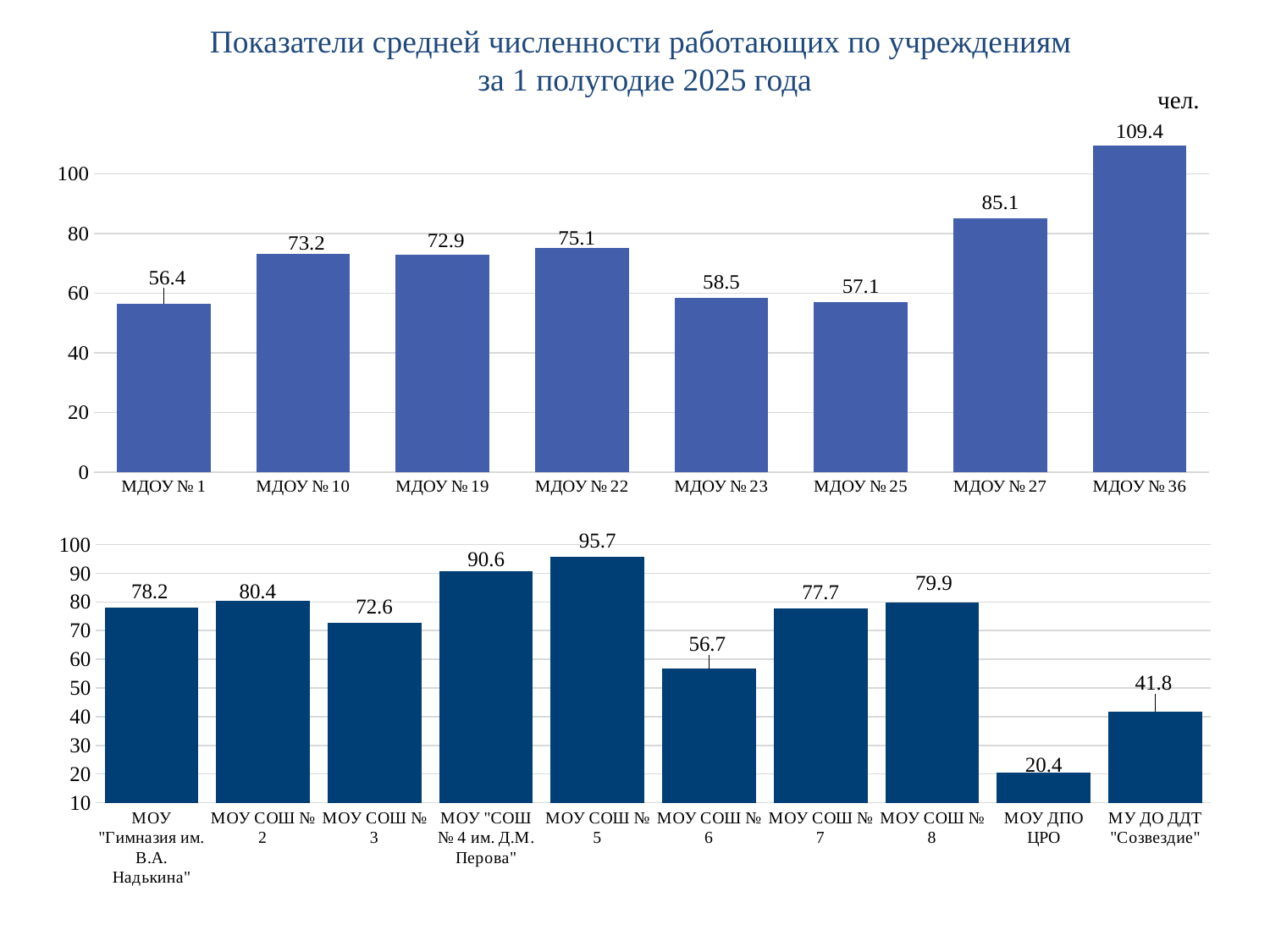
On the top chart, which institution has the highest value? МДОУ № 36 On the top chart, what is the difference between МДОУ № 36 and МДОУ № 27? 24.3 On the bottom chart, which institution has the lowest value? МОУ ДПО ЦРО What type of chart is the top chart? Bar chart On the top chart, how many institutions are shown? 8 On the bottom chart, how many institutions are shown? 10 On the bottom chart, what is the value for МОУ СОШ № 6? 56.7 On the bottom chart, which institution has the highest value? МОУ СОШ № 5 On the bottom chart, which is larger: the value for МОУ СОШ № 2 or МОУ СОШ № 3? МОУ СОШ № 2 On the top chart, what is the value for МДОУ № 27? 85.1 On the top chart, which institution has the lowest value? МДОУ № 1 On the bottom chart, what is the difference between МОУ "СОШ № 4 им. Д.М. Перова" and МУ ДО ДДТ "Созвездие"? 48.8